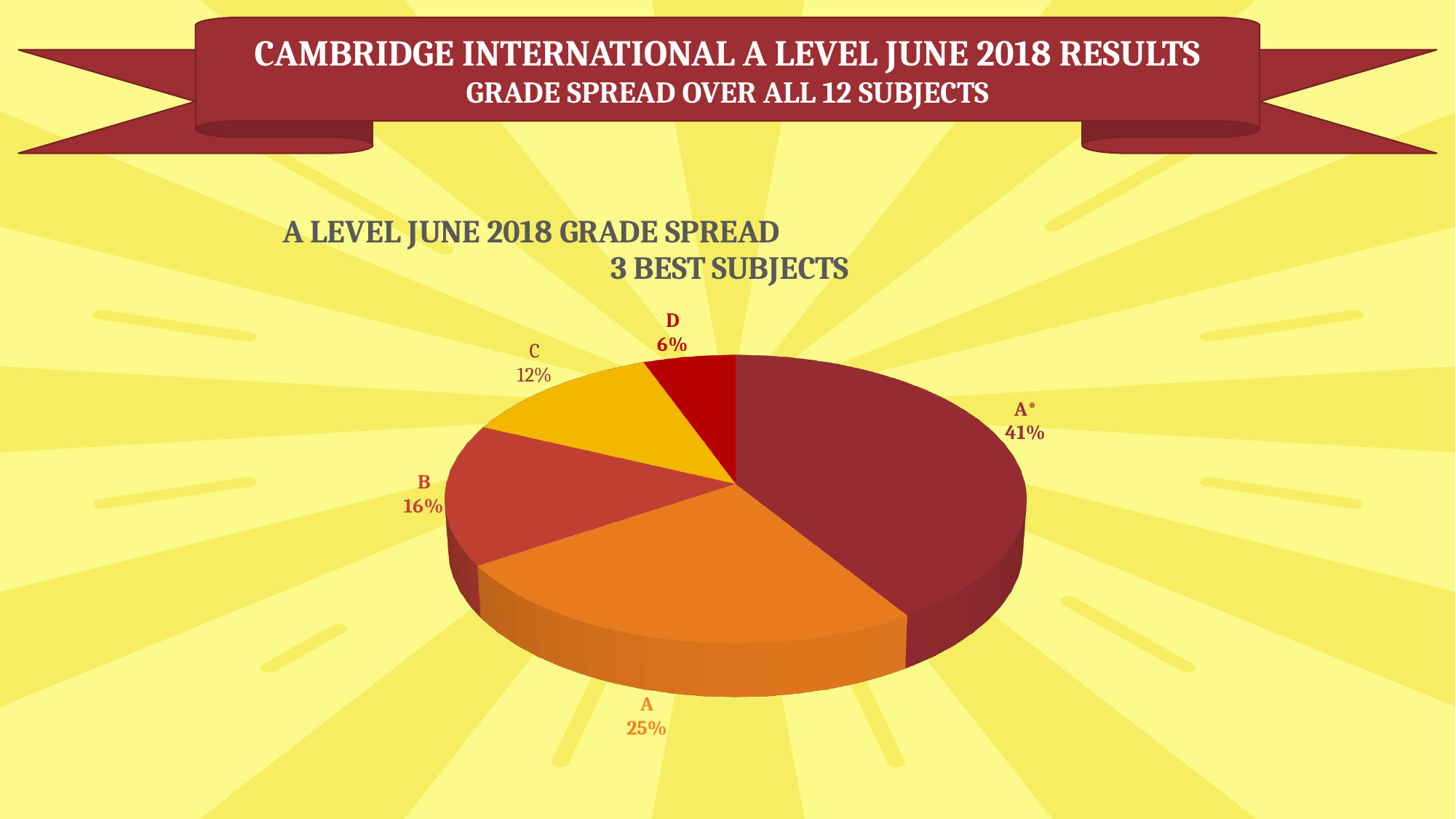
How many grade categories are shown in the pie chart? 5 Which grade has the largest share of the pie? A* What is the combined share of the A* and A slices? 66% Which grade has the smallest share of the pie? D What percentage of grades were B? 16% What colour is the C slice of the pie? Yellow What percentage of grades were A*? 41% Which slice is larger, C or B? B What is the title of the chart? A LEVEL JUNE 2018 GRADE SPREAD 3 BEST SUBJECTS What is the difference in percentage points between the A* and A slices? 16 What percentage of grades were D? 6% What kind of chart is shown on the slide? Pie chart